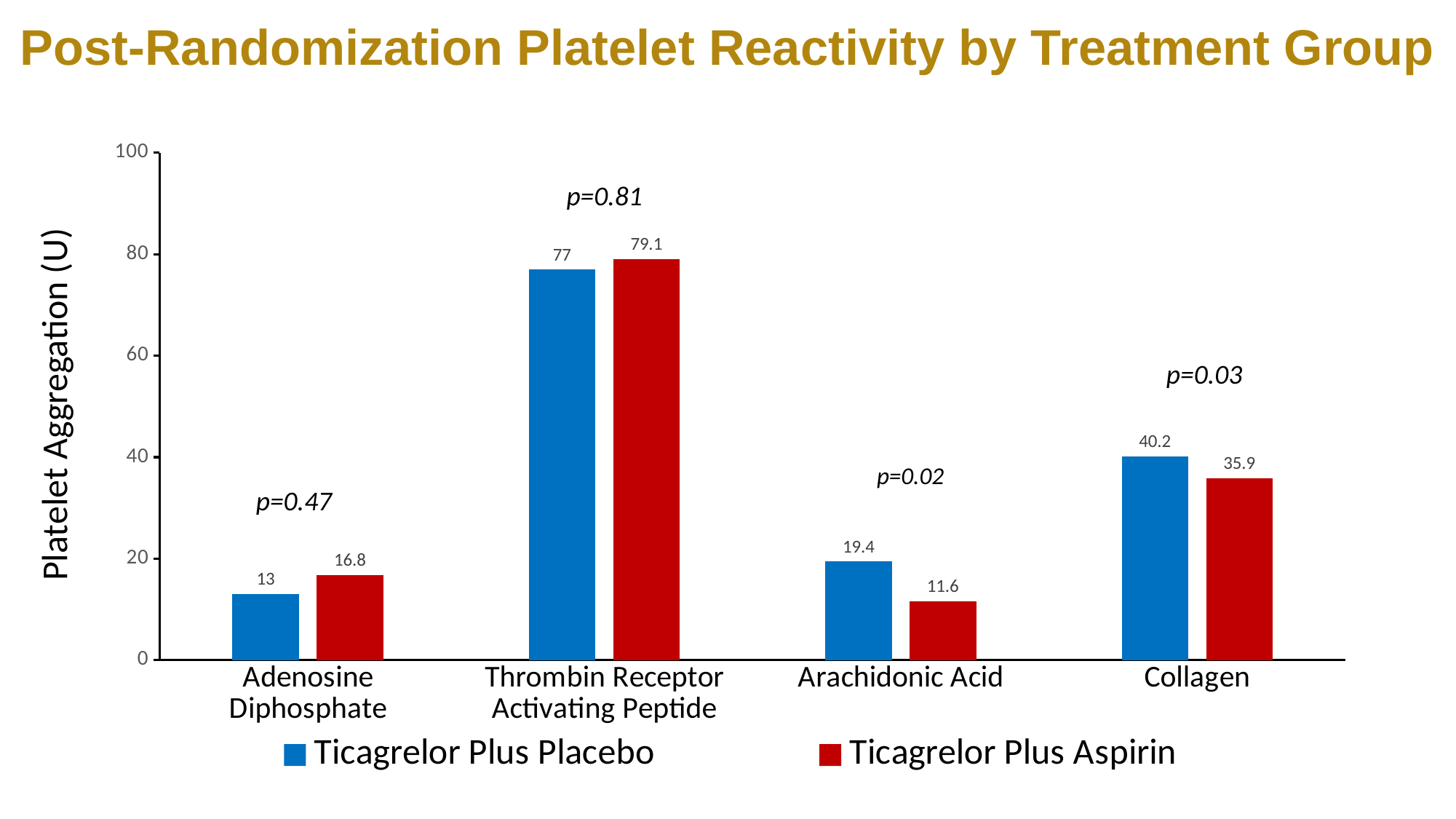
How many series does the legend list? 2 What is the platelet aggregation value for Ticagrelor Plus Placebo in the Adenosine Diphosphate category? 13 What is the difference between the Ticagrelor Plus Placebo and Ticagrelor Plus Aspirin values in the Arachidonic Acid category? 7.8 What p-value is shown above the Collagen category? p=0.03 Is the value for Ticagrelor Plus Placebo in the Collagen category greater or less than 20? greater Which category has the highest value for Ticagrelor Plus Placebo? Thrombin Receptor Activating Peptide How many categories are shown on the x axis? 4 What is the value for Ticagrelor Plus Aspirin in the Thrombin Receptor Activating Peptide category? 79.1 In the Collagen category, which treatment group has the larger value? Ticagrelor Plus Placebo What is the platelet aggregation value for Ticagrelor Plus Aspirin in the Collagen category? 35.9 What kind of chart is shown on the slide? Bar chart Which category has the lowest value for Ticagrelor Plus Aspirin? Arachidonic Acid